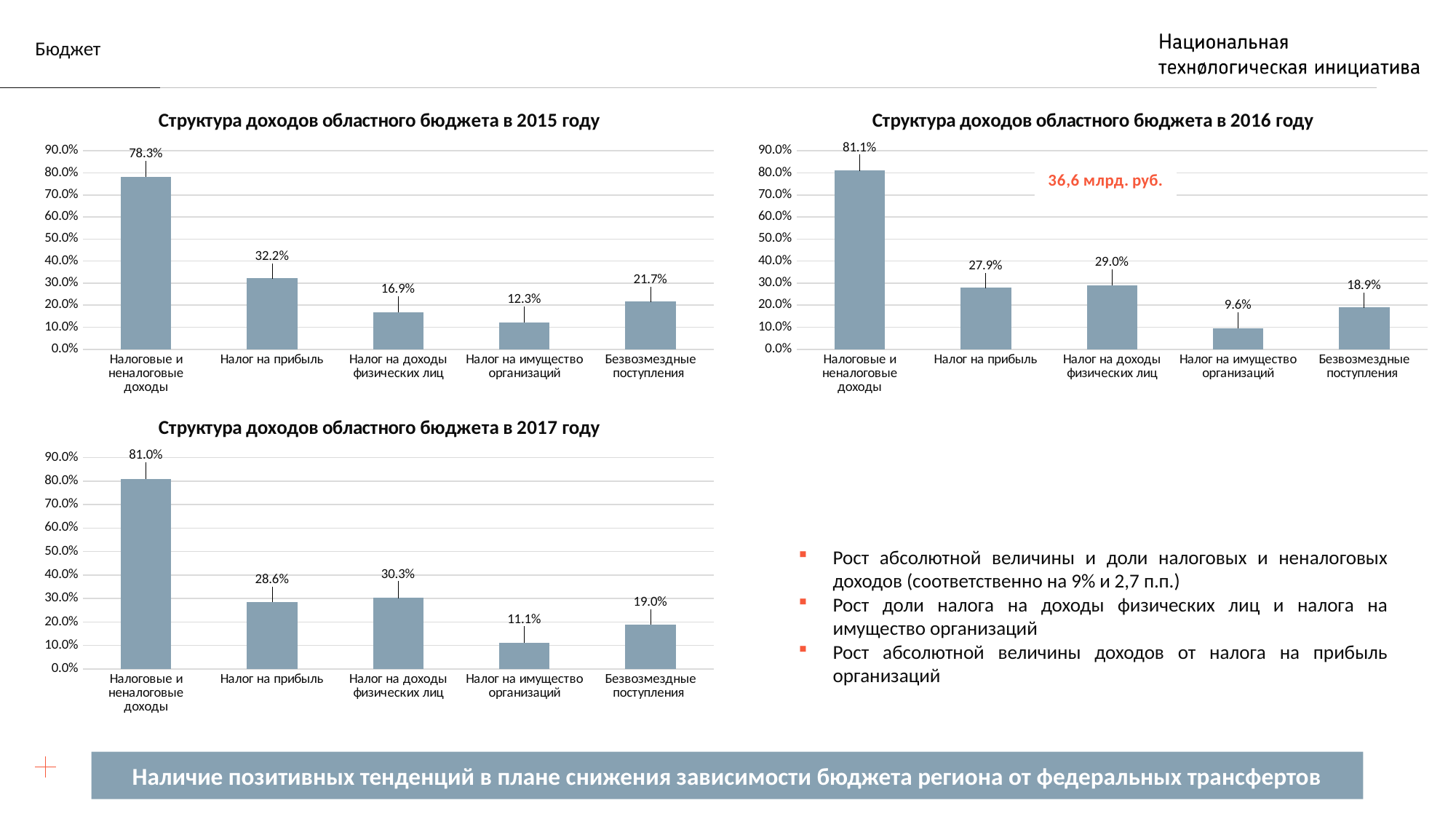
In the chart 'Структура доходов областного бюджета в 2016 году', what is the difference between 'Налог на доходы физических лиц' and 'Налог на прибыль'? 1.1 percentage points What kind of chart is 'Структура доходов областного бюджета в 2015 году'? Bar chart In the chart 'Структура доходов областного бюджета в 2017 году', is the value for 'Налог на доходы физических лиц' greater or less than 20.0%? greater In the chart 'Структура доходов областного бюджета в 2015 году', which is larger: 'Безвозмездные поступления' or 'Налог на доходы физических лиц'? Безвозмездные поступления In the chart 'Структура доходов областного бюджета в 2016 году', what is the value for 'Налог на имущество организаций'? 9.6% How many categories are shown in the chart 'Структура доходов областного бюджета в 2016 году'? 5 What amount in rubles is printed in red on the chart 'Структура доходов областного бюджета в 2016 году'? 36,6 млрд. руб. In the chart 'Структура доходов областного бюджета в 2015 году', what is the difference between 'Налоговые и неналоговые доходы' and 'Налог на прибыль'? 46.1 percentage points In the chart 'Структура доходов областного бюджета в 2015 году', which category has the lowest value? Налог на имущество организаций In the chart 'Структура доходов областного бюджета в 2015 году', what is the value for 'Налог на прибыль'? 32.2% In the chart 'Структура доходов областного бюджета в 2017 году', what is the value for 'Безвозмездные поступления'? 19.0% In the chart 'Структура доходов областного бюджета в 2017 году', which category has the highest value? Налоговые и неналоговые доходы